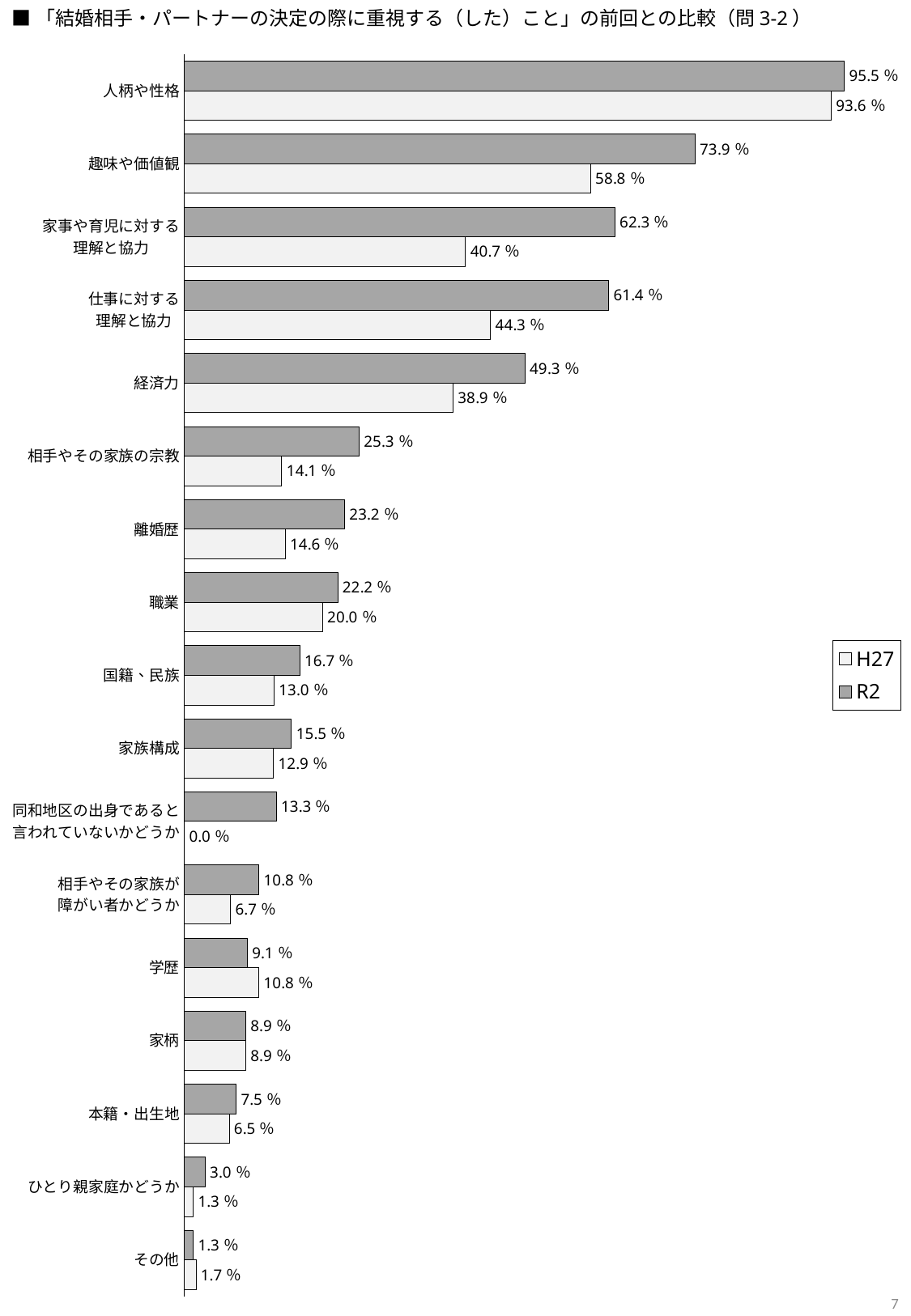
Which category has the highest R2 value? 人柄や性格 How many categories are shown in the chart? 17 What is the H27 value for 経済力? 38.9 % What is the R2 value for 人柄や性格? 95.5 % What is the difference between the R2 and H27 values for 家事や育児に対する理解と協力? 21.6 % For 学歴, which is larger, the H27 value or the R2 value? H27 What is the H27 value for 同和地区の出身であると言われていないかどうか? 0.0 % What is the difference between the R2 and H27 values for 趣味や価値観? 15.1 % What is the R2 value for 学歴? 9.1 % What kind of chart is shown on the slide? Bar chart How many series does the legend list? 2 Which category has the lowest H27 value? 同和地区の出身であると言われていないかどうか